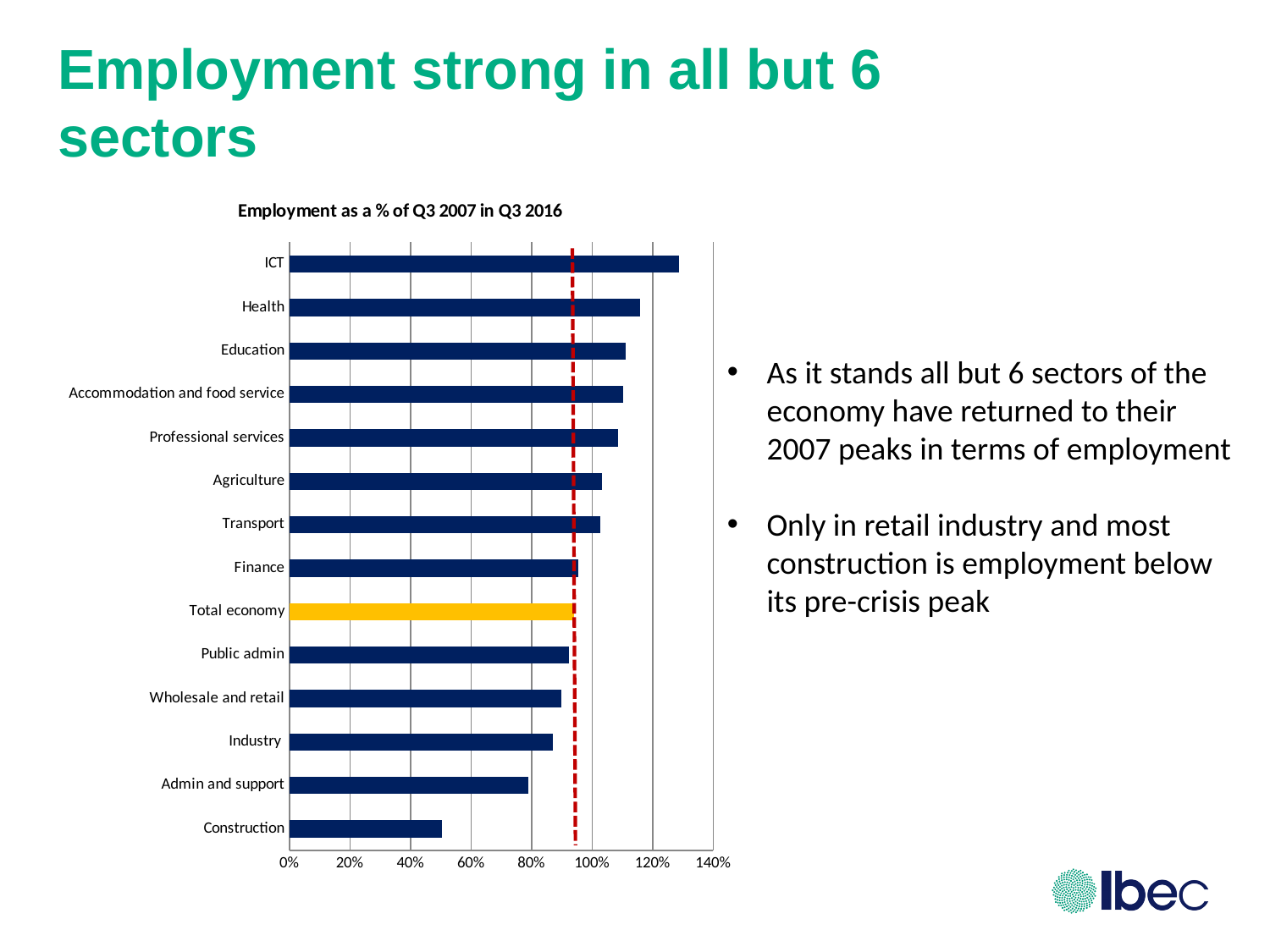
Is the value for Health greater or less than 100%? greater Which has the larger value, ICT or Health? ICT Is the value for Industry greater or less than 100%? less Which category has the highest value in the chart? ICT What kind of chart is shown on the slide? bar chart Which category has the lowest value in the chart? Construction What is the title of the chart? Employment as a % of Q3 2007 in Q3 2016 How many categories are plotted in the chart? 14 Which has the larger value, Construction or Admin and support? Admin and support Is the value for Construction greater or less than 60%? less Which category's bar is coloured differently (yellow) from the others? Total economy